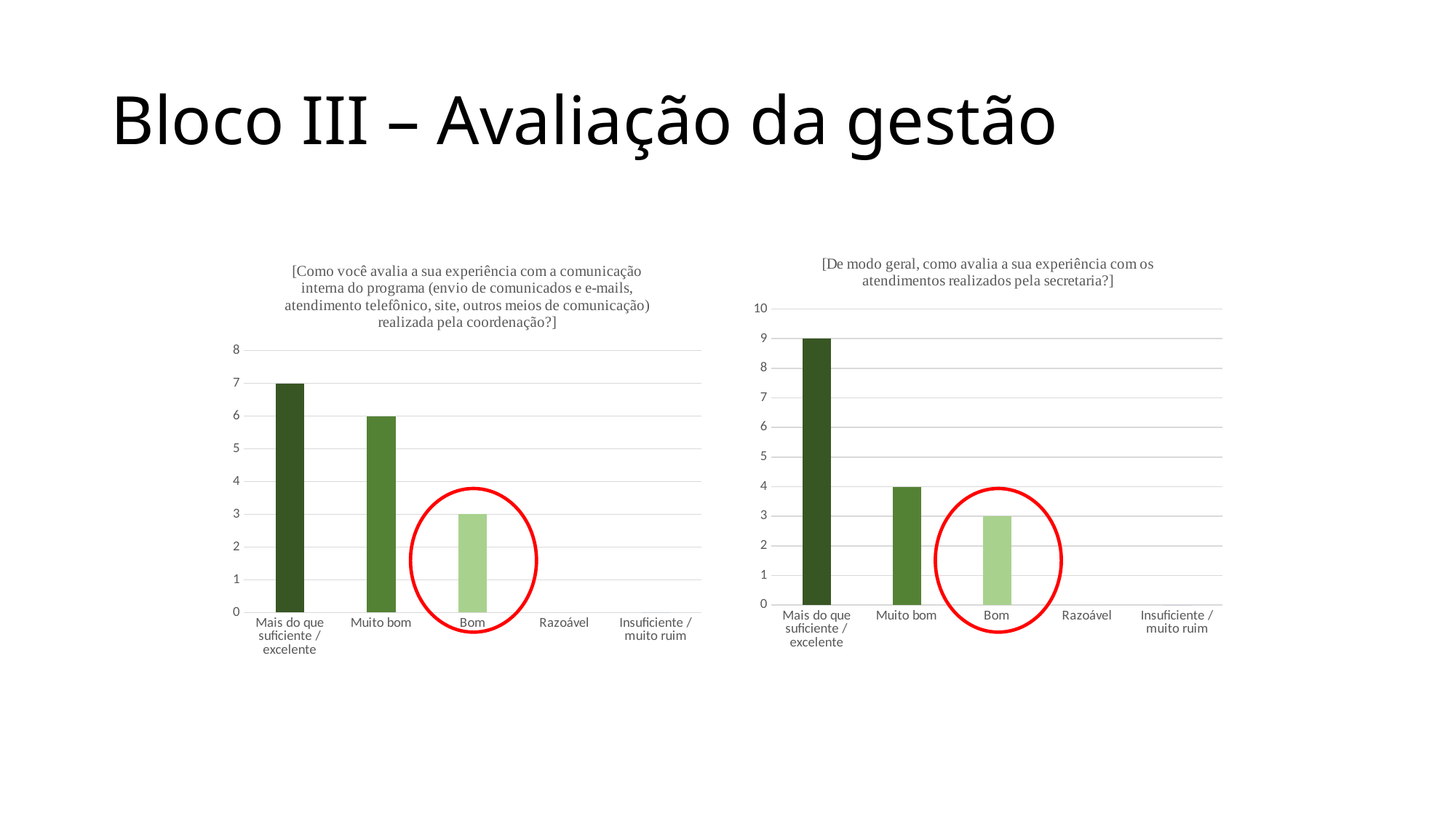
In the right chart, what is the value for 'Mais do que suficiente / excelente'? 9 In the left chart, what is the value for 'Muito bom'? 6 In the right chart, what is the value for 'Bom'? 3 In the right chart, which category has the highest value? Mais do que suficiente / excelente In the right chart, do the values rise or fall from left to right along the x axis? fall In the left chart, what is the value for 'Mais do que suficiente / excelente'? 7 In the right chart, what is the difference between 'Mais do que suficiente / excelente' and 'Muito bom'? 5 What kind of chart is the right chart? bar chart How many categories are shown on the x axis of the left chart? 5 In the right chart, is the value for 'Mais do que suficiente / excelente' greater or less than 8? greater In the left chart, which is larger, 'Muito bom' or 'Bom'? Muito bom In the left chart, what is the difference between 'Mais do que suficiente / excelente' and 'Bom'? 4